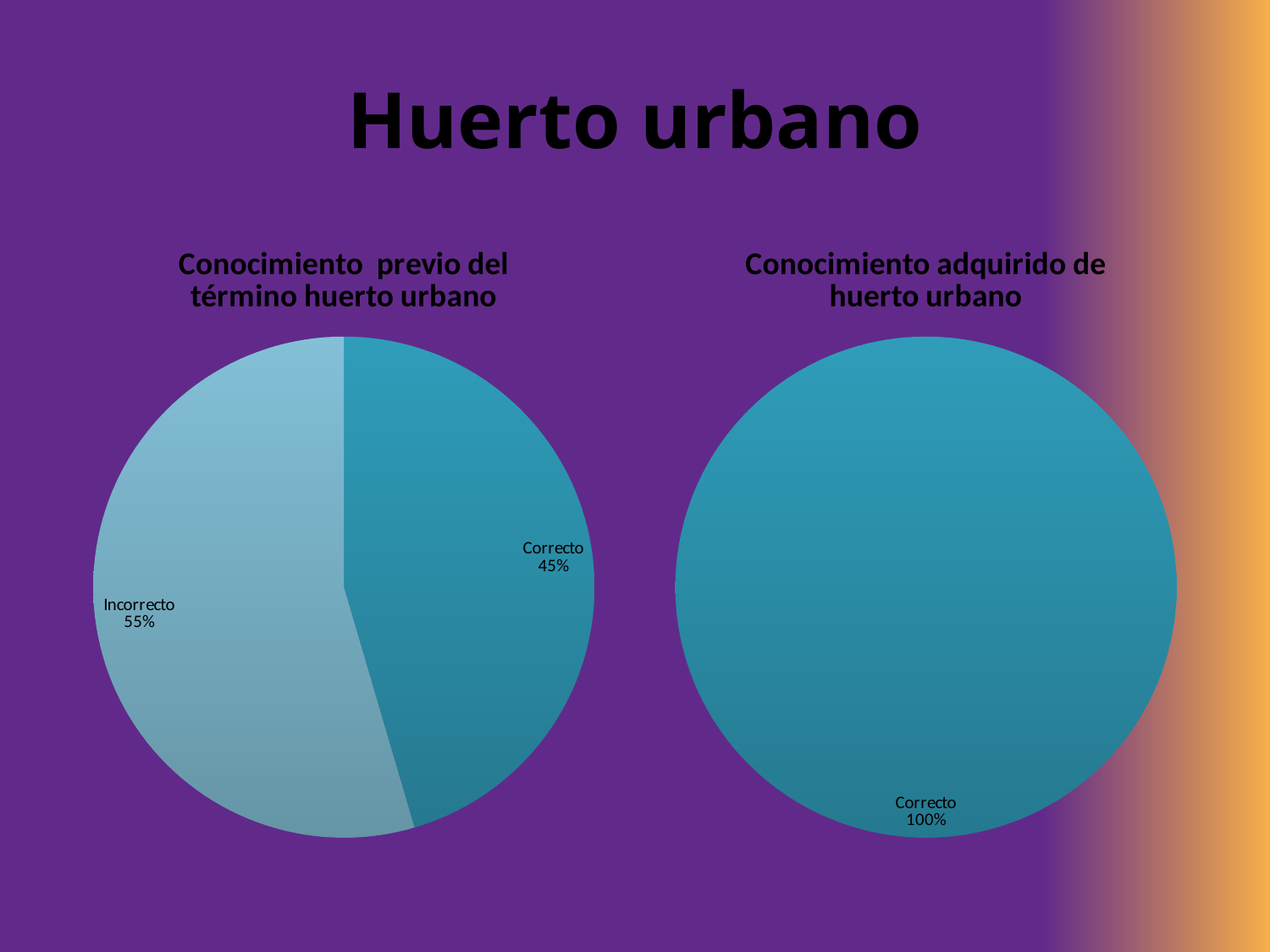
In the chart titled "Conocimiento previo del término huerto urbano", what share does the Correcto slice have? 45% In the left chart, which slice is the smallest? Correcto In the chart titled "Conocimiento previo del término huerto urbano", what share does the Incorrecto slice have? 55% What is the title of the left chart? Conocimiento previo del término huerto urbano In the left chart, which is larger, Incorrecto or Correcto? Incorrecto How many slices does the left chart have? 2 In the left chart, what is the difference between the Incorrecto and Correcto shares? 10% In the chart titled "Conocimiento adquirido de huerto urbano", what share does the Correcto slice have? 100% In the left chart, which slice is the largest? Incorrecto How many slices does the right chart have? 1 How many charts are on the slide? 2 What kind of chart is the chart titled "Conocimiento adquirido de huerto urbano"? Pie chart